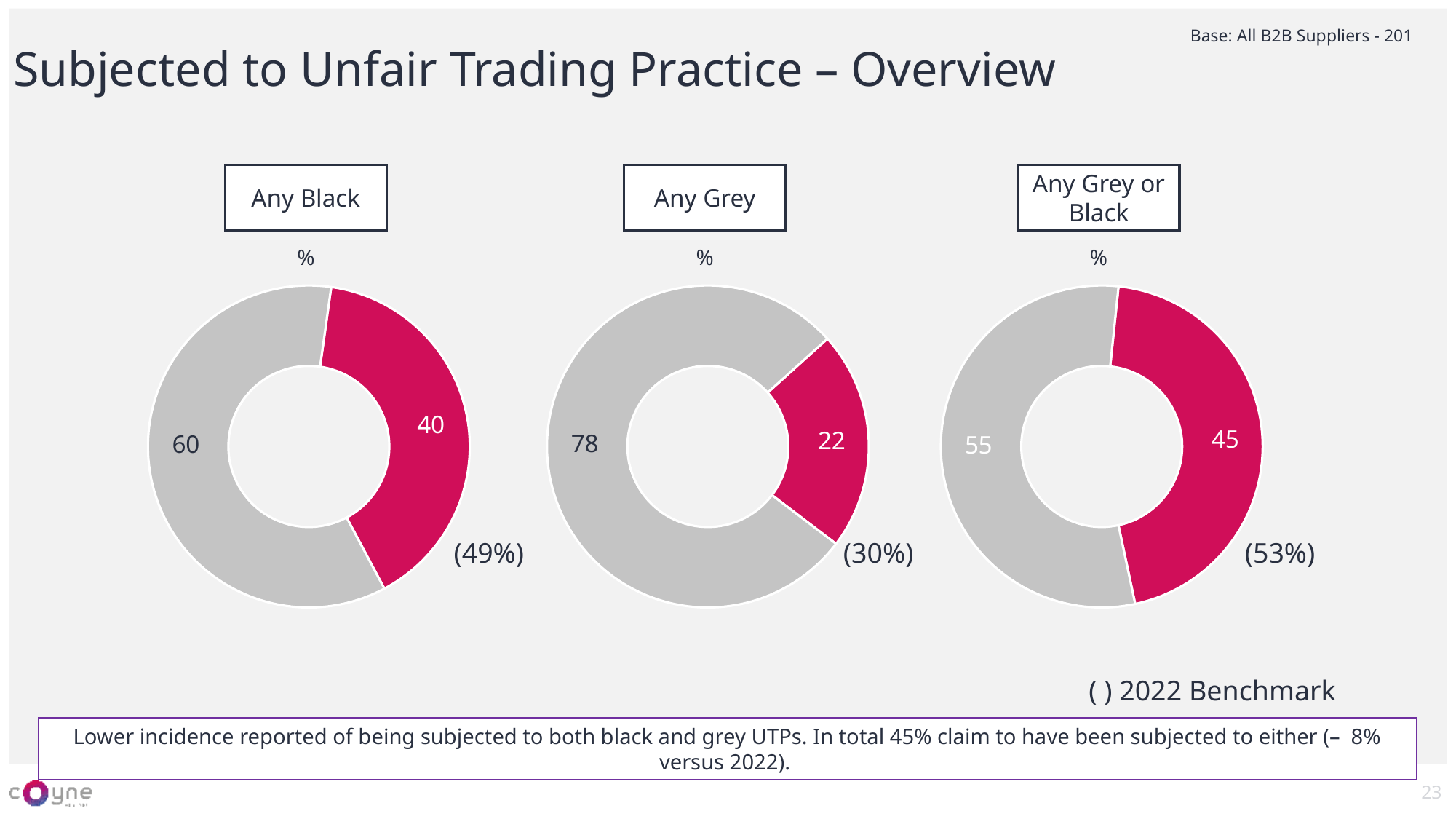
Across the three charts, which one has the largest pink segment? Any Grey or Black What 2022 benchmark figure is shown in parentheses next to the 'Any Black' chart? (49%) Is the pink segment in the 'Any Black' chart larger or smaller than the pink segment in the 'Any Grey or Black' chart? smaller How many donut charts are shown on the slide? 3 In the 'Any Black' chart, what value is shown for the pink segment? 40 In the 'Any Grey or Black' chart, what value is shown for the pink segment? 45 What 2022 benchmark figure is shown in parentheses next to the 'Any Grey' chart? (30%) Across the three charts, which one has the smallest pink segment? Any Grey In the 'Any Grey' chart, what is the difference between the grey segment value and the pink segment value? 56 In the 'Any Grey' chart, what value is shown for the grey segment? 78 What type of chart is used on this slide? Donut chart In the 'Any Grey or Black' chart, what is the total of the two segment values? 100